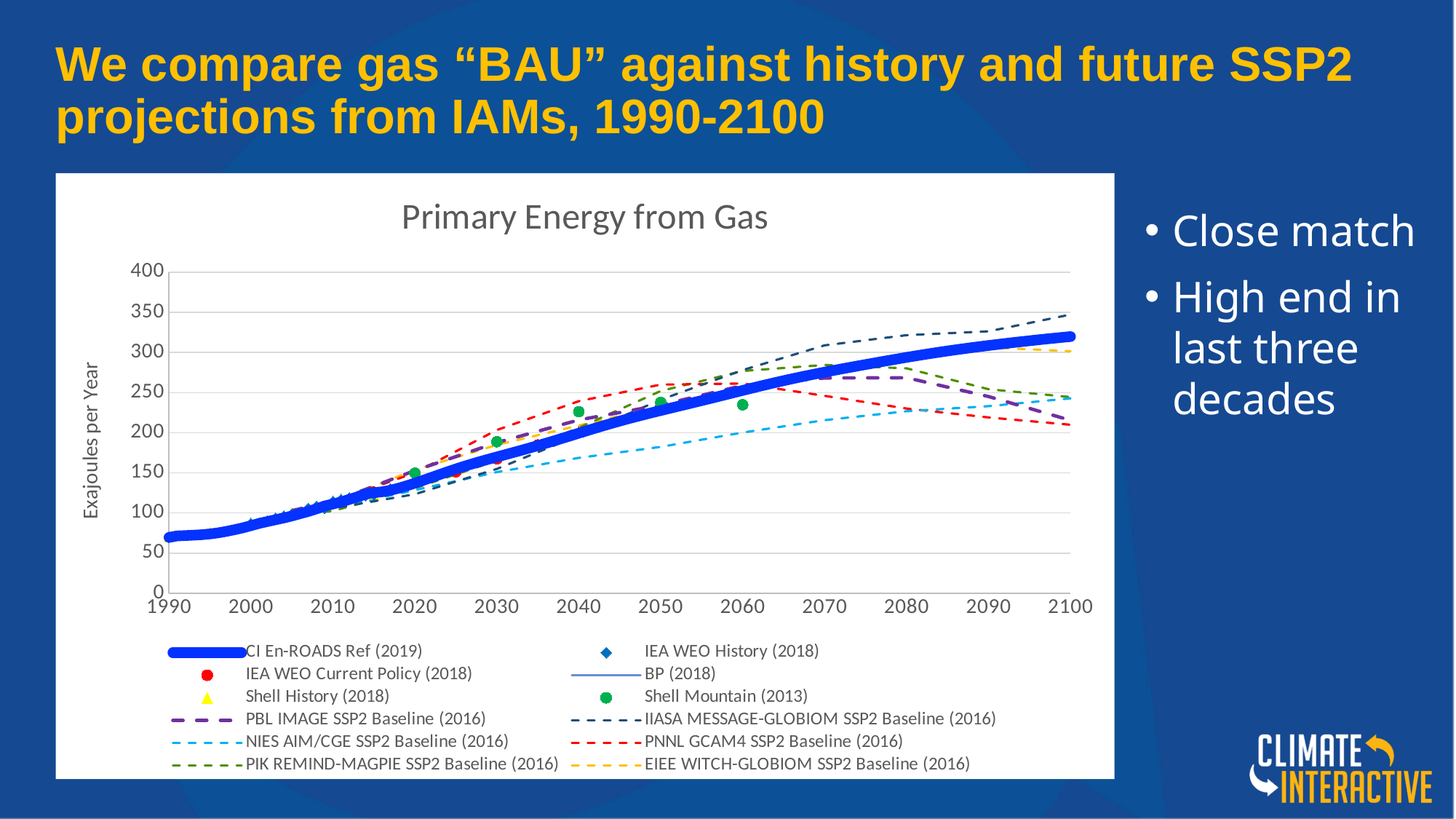
How many series does the chart legend list? 12 Is the value of the CI En-ROADS Ref (2019) line in 2100 greater or less than 300? greater What is the highest value shown on the vertical axis? 400 Is the value of the IIASA MESSAGE-GLOBIOM SSP2 Baseline (2016) line in 2100 greater or less than 300? greater What type of chart is shown on the slide? line chart What is the title of the chart? Primary Energy from Gas What is the label on the vertical axis of the chart? Exajoules per Year Does the CI En-ROADS Ref (2019) line rise or fall from 1990 to 2100? rise Is the value of the PNNL GCAM4 SSP2 Baseline (2016) line in 2100 greater or less than 250? less Which series reaches the highest value in 2100? IIASA MESSAGE-GLOBIOM SSP2 Baseline (2016) In 2100, which is larger: the IIASA MESSAGE-GLOBIOM SSP2 Baseline (2016) value or the PNNL GCAM4 SSP2 Baseline (2016) value? IIASA MESSAGE-GLOBIOM SSP2 Baseline (2016)